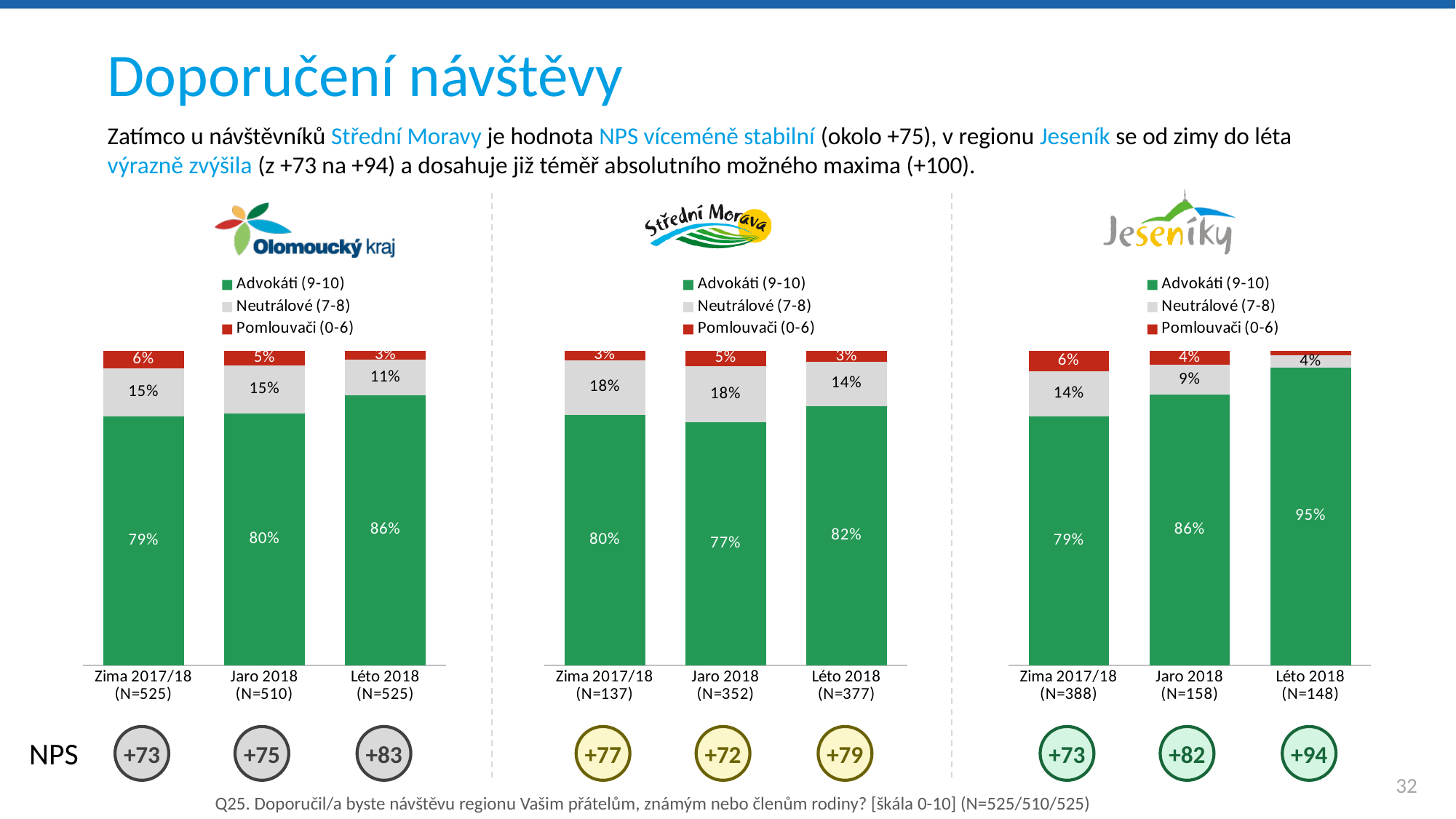
In the Jeseníky chart, what is the difference between the Advokáti (9-10) share in Léto 2018 and in Zima 2017/18? 16 percentage points What kind of chart is used for Olomoucký kraj? Stacked bar chart In the Střední Morava chart, what is the value for Neutrálové (7-8) in Zima 2017/18? 18% In the Olomoucký kraj chart, what is the value for Advokáti (9-10) in Léto 2018? 86% In the Olomoucký kraj chart, which colour represents Pomlouvači (0-6)? Red In the Jeseníky chart, does the share of Advokáti (9-10) rise or fall from Zima 2017/18 to Léto 2018? Rise In the Olomoucký kraj chart, which is larger: the Neutrálové (7-8) share in Jaro 2018 or in Léto 2018? Jaro 2018 How many periods (categories) are shown in the Střední Morava chart? 3 How many series does the legend of the Jeseníky chart list? 3 In the Jeseníky chart, which period has the highest share of Advokáti (9-10)? Léto 2018 In the Střední Morava chart, which period has the lowest share of Advokáti (9-10)? Jaro 2018 In the Jeseníky chart, what is the value for Pomlouvači (0-6) in Jaro 2018? 4%